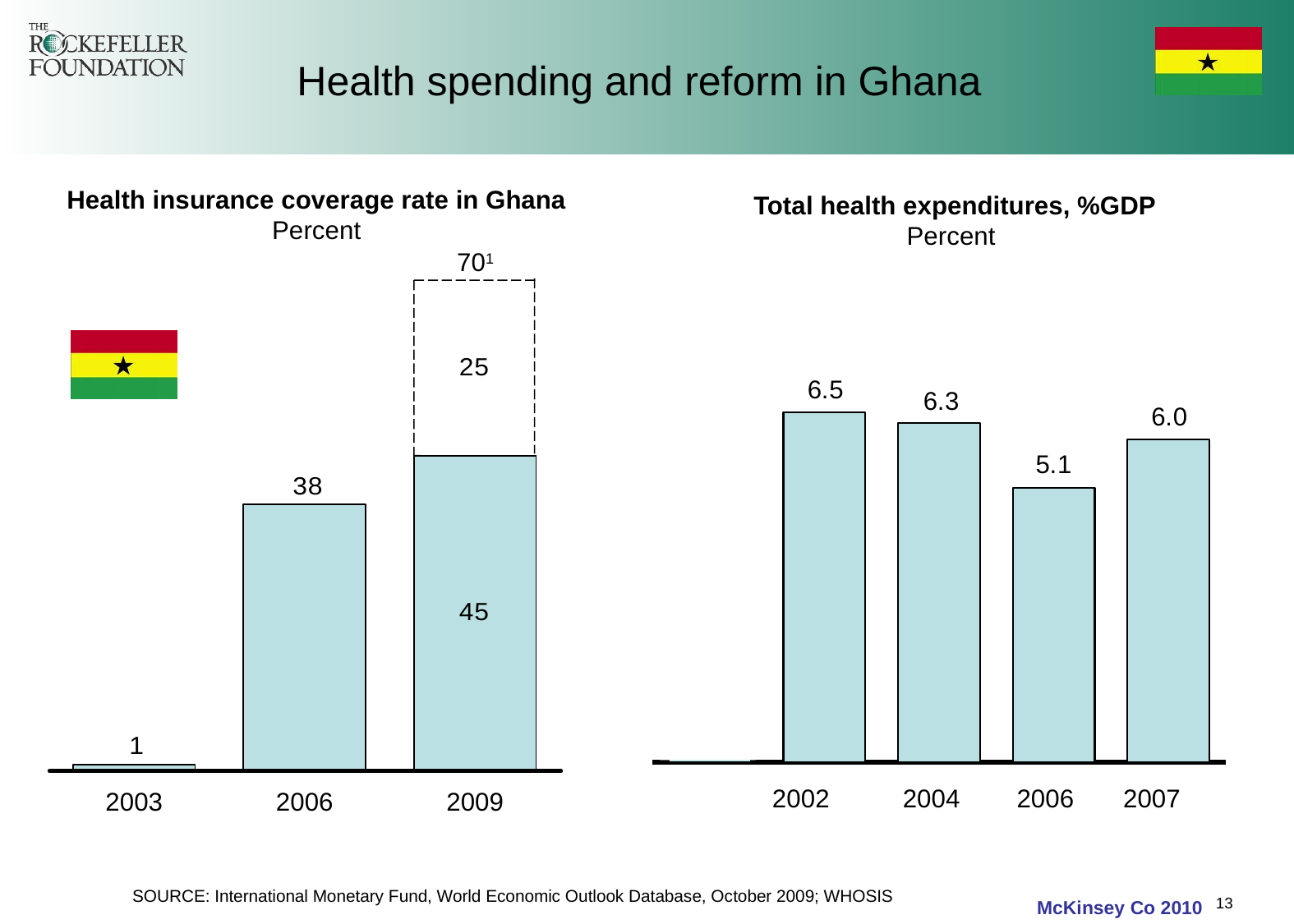
In the 'Health insurance coverage rate in Ghana' chart, what is the value for 2003? 1 In the 'Health insurance coverage rate in Ghana' chart, what is the difference between the 2006 value and the 2003 value? 37 In the 'Total health expenditures, %GDP' chart, what is the value for 2006? 5.1 In the 'Total health expenditures, %GDP' chart, which is larger, the value for 2004 or the value for 2007? 2004 In the 'Total health expenditures, %GDP' chart, what is the difference between the 2002 value and the 2007 value? 0.5 In the 'Health insurance coverage rate in Ghana' chart, how many years are shown on the x axis? 3 In the 'Health insurance coverage rate in Ghana' chart, what is the value for 2006? 38 What kind of chart is the 'Total health expenditures, %GDP' chart? Bar chart In the 'Health insurance coverage rate in Ghana' chart, what is the value of the solid (lower) portion of the 2009 bar? 45 In the 'Total health expenditures, %GDP' chart, which year has the lowest value? 2006 In the 'Health insurance coverage rate in Ghana' chart, what is the total shown at the top of the 2009 bar? 70 In the 'Total health expenditures, %GDP' chart, which year has the highest value? 2002